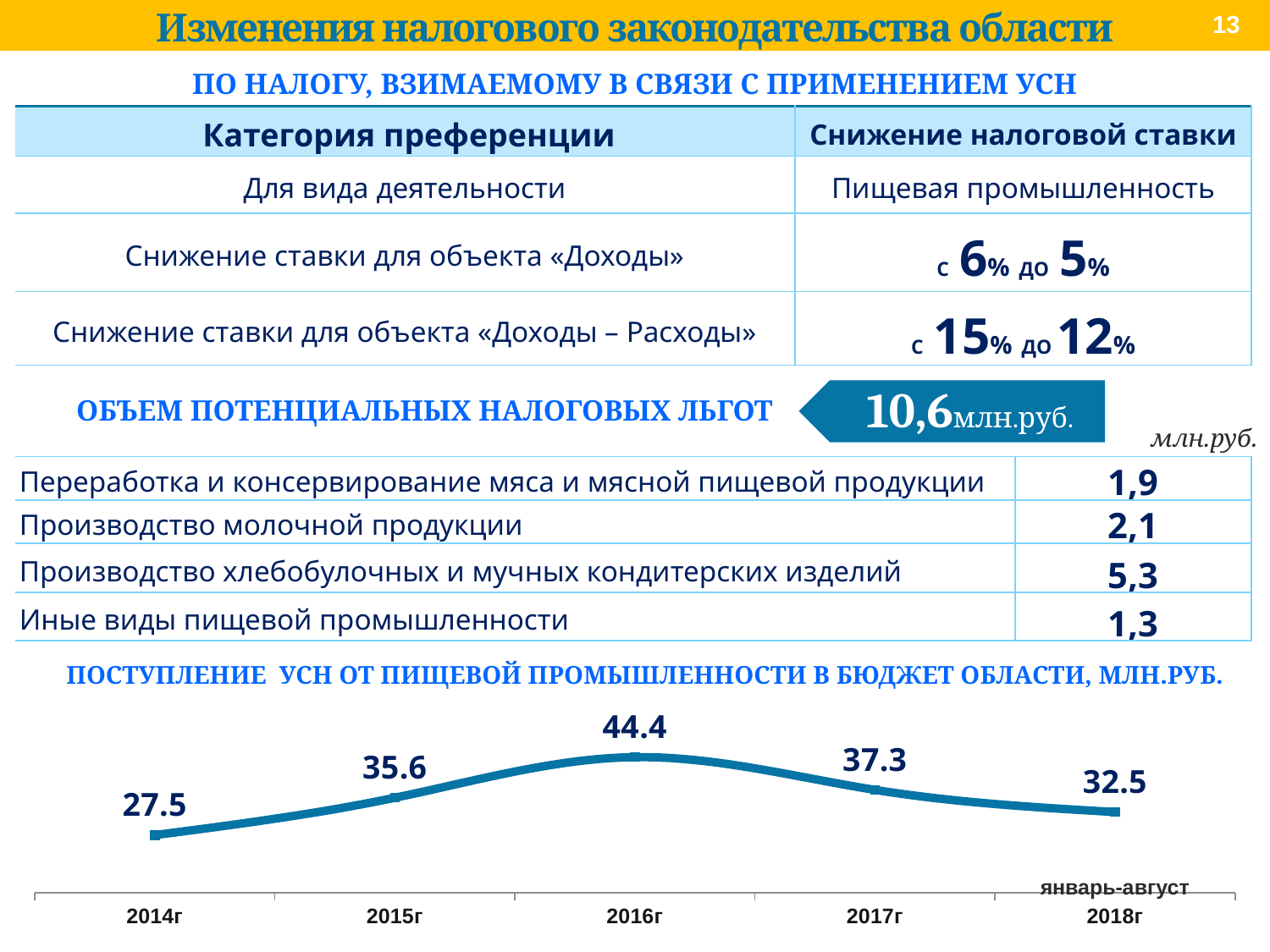
How many data points are plotted in the line chart? 5 Which year has the highest value in the line chart? 2016г What is the title of the line chart? ПОСТУПЛЕНИЕ УСН ОТ ПИЩЕВОЙ ПРОМЫШЛЕННОСТИ В БЮДЖЕТ ОБЛАСТИ, МЛН.РУБ. Does the line chart rise or fall from 2014г to 2016г? rise What type of chart is shown at the bottom of the slide? line chart What is the value for 2016г in the line chart? 44.4 What is the value for 2017г in the line chart? 37.3 What is the difference between the values for 2016г and 2015г in the line chart? 8.8 What is the value for 2014г in the line chart? 27.5 What is the value for январь-август 2018г in the line chart? 32.5 Which year has the lowest value in the line chart? 2014г Which is larger in the line chart, the value for 2015г or the value for 2017г? 2017г